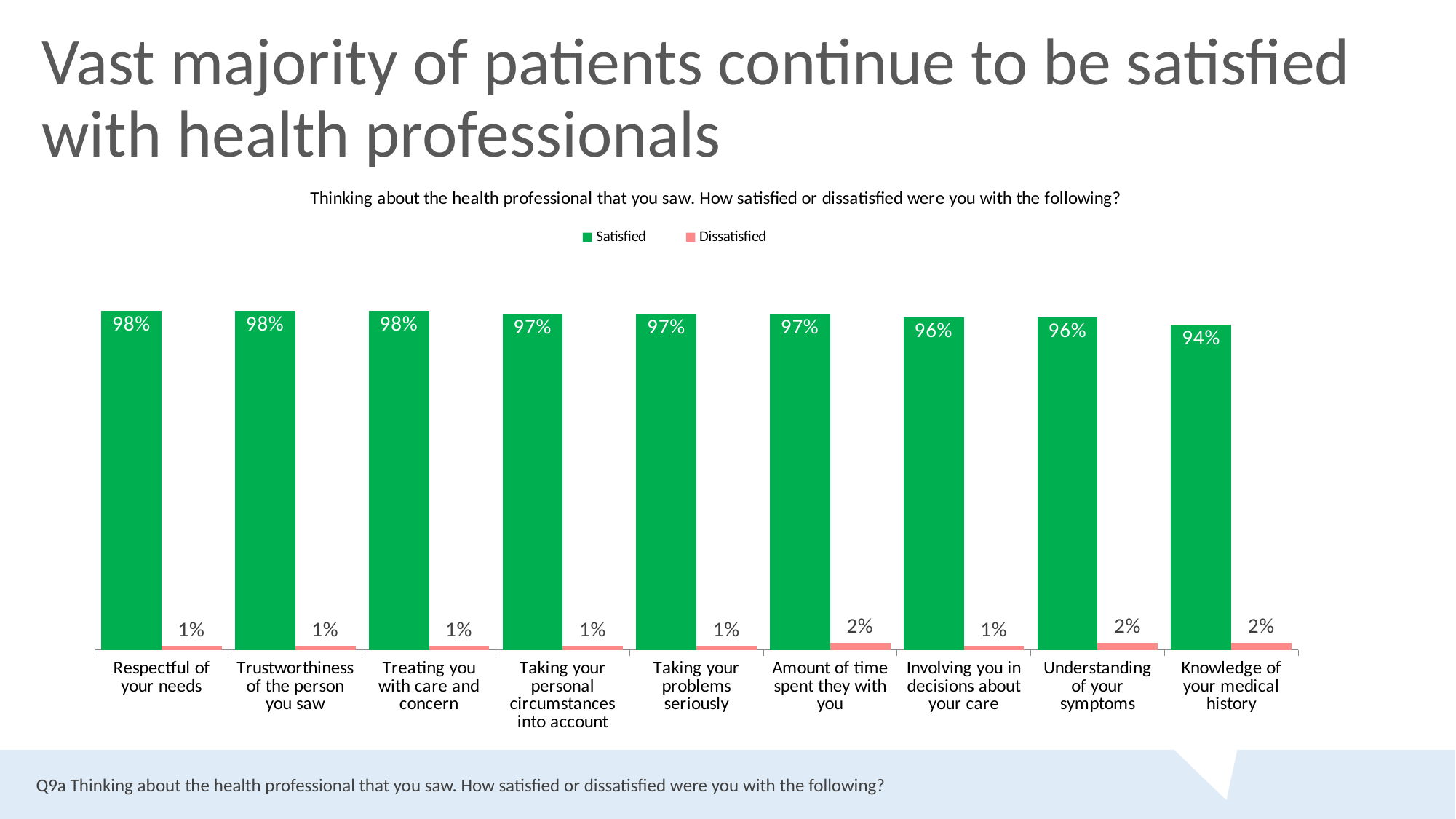
What is the Dissatisfied value for "Involving you in decisions about your care"? 1% What is the difference between the Satisfied values for "Respectful of your needs" and "Knowledge of your medical history"? 4% What is the Dissatisfied value for "Amount of time spent they with you"? 2% What colour are the Dissatisfied bars? Pink What is the Satisfied value for "Taking your personal circumstances into account"? 97% What kind of chart is shown on the slide? Bar chart Do the Satisfied values rise or fall from left to right along the x axis? Fall Which category has the lowest Satisfied value? Knowledge of your medical history How many categories are shown on the x axis? 9 Which is larger: the Satisfied value for "Taking your problems seriously" or for "Understanding of your symptoms"? Taking your problems seriously What is the Satisfied value for "Knowledge of your medical history"? 94% How many series does the legend list? 2